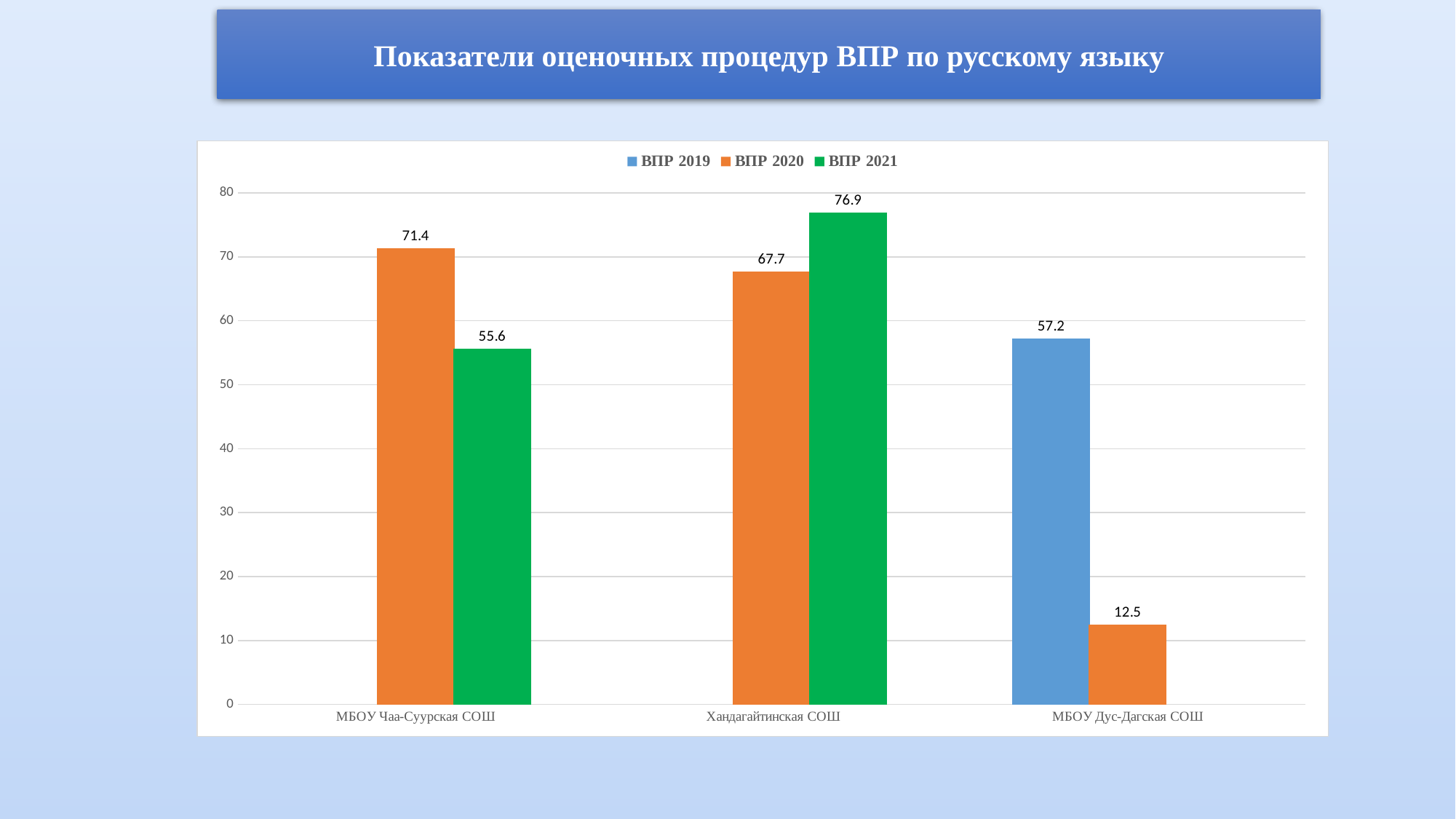
Is the ВПР 2021 value for МБОУ Чаа-Суурская СОШ greater or less than 60? less Which school has the highest ВПР 2020 value? МБОУ Чаа-Суурская СОШ What is the ВПР 2020 value for МБОУ Дус-Дагская СОШ? 12.5 Which is larger for МБОУ Чаа-Суурская СОШ: the ВПР 2020 value or the ВПР 2021 value? ВПР 2020 What is the ВПР 2019 value for МБОУ Дус-Дагская СОШ? 57.2 What is the ВПР 2020 value for МБОУ Чаа-Суурская СОШ? 71.4 What type of chart is shown on the slide? bar chart How many schools are shown on the x axis? 3 Which school has the lowest ВПР 2020 value? МБОУ Дус-Дагская СОШ What is the difference between the ВПР 2021 and ВПР 2020 values for Хандагайтинская СОШ? 9.2 How many series does the legend list? 3 What is the ВПР 2021 value for Хандагайтинская СОШ? 76.9